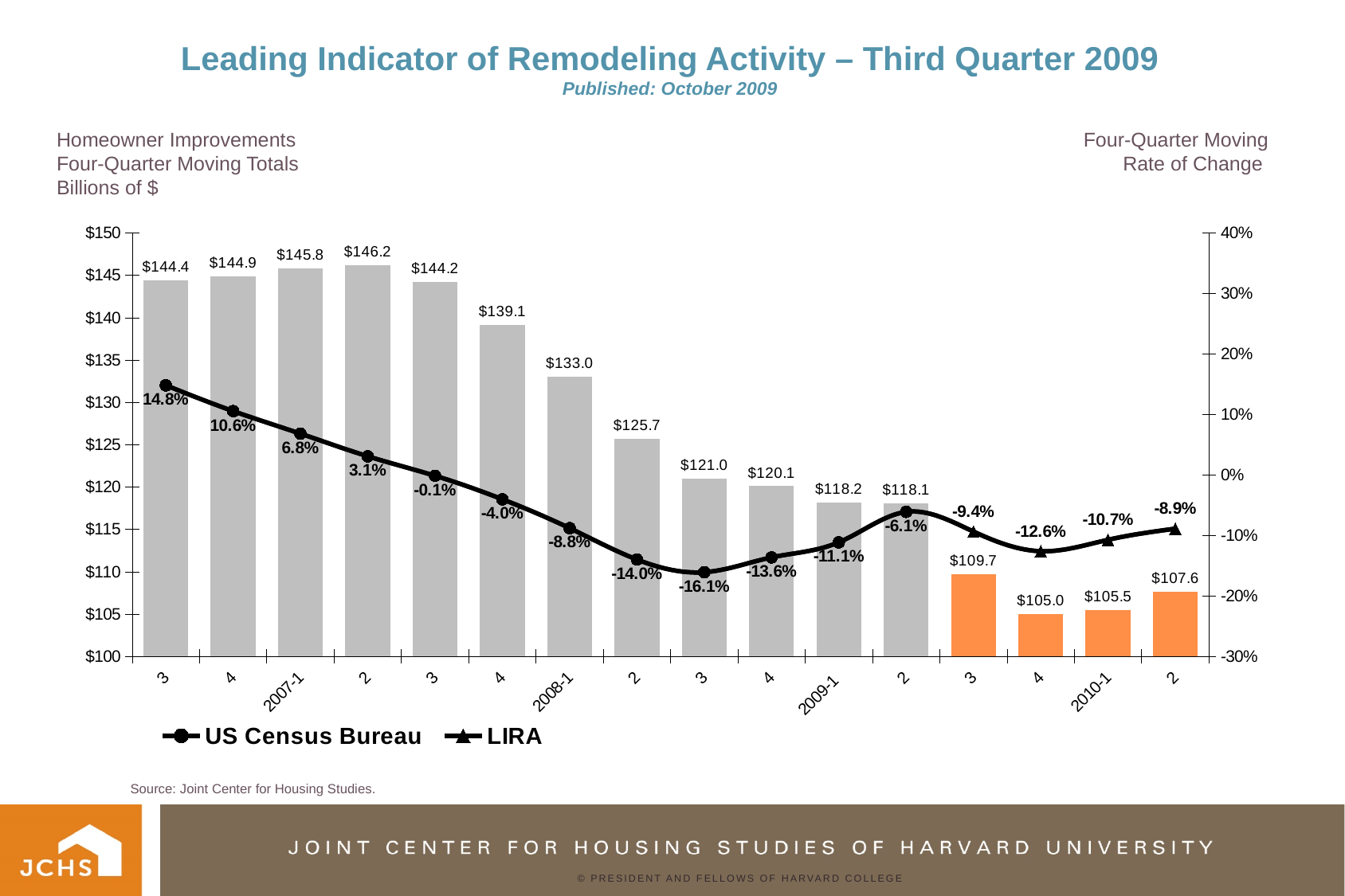
What is the four-quarter moving rate of change shown for 2007-1? 6.8% What is the highest four-quarter moving total shown by any bar? $146.2 What is the four-quarter moving total for 2009-1? $118.2 What is the lowest four-quarter moving rate of change shown on the line? -16.1% Which has the larger four-quarter moving total, 2009-1 or 2010-1? 2009-1 What is the difference between the four-quarter moving totals for 2008-1 and 2009-1? $14.8 What is the four-quarter moving total (in billions of $) for 2008-1? $133.0 Do the four-quarter moving totals generally rise or fall from the first bar to the last bar? fall What is the four-quarter moving rate of change shown for 2010-1? -10.7% How many bars (quarters) are plotted on the chart? 16 How many series does the legend list? 2 What is the lowest four-quarter moving total shown by any bar? $105.0